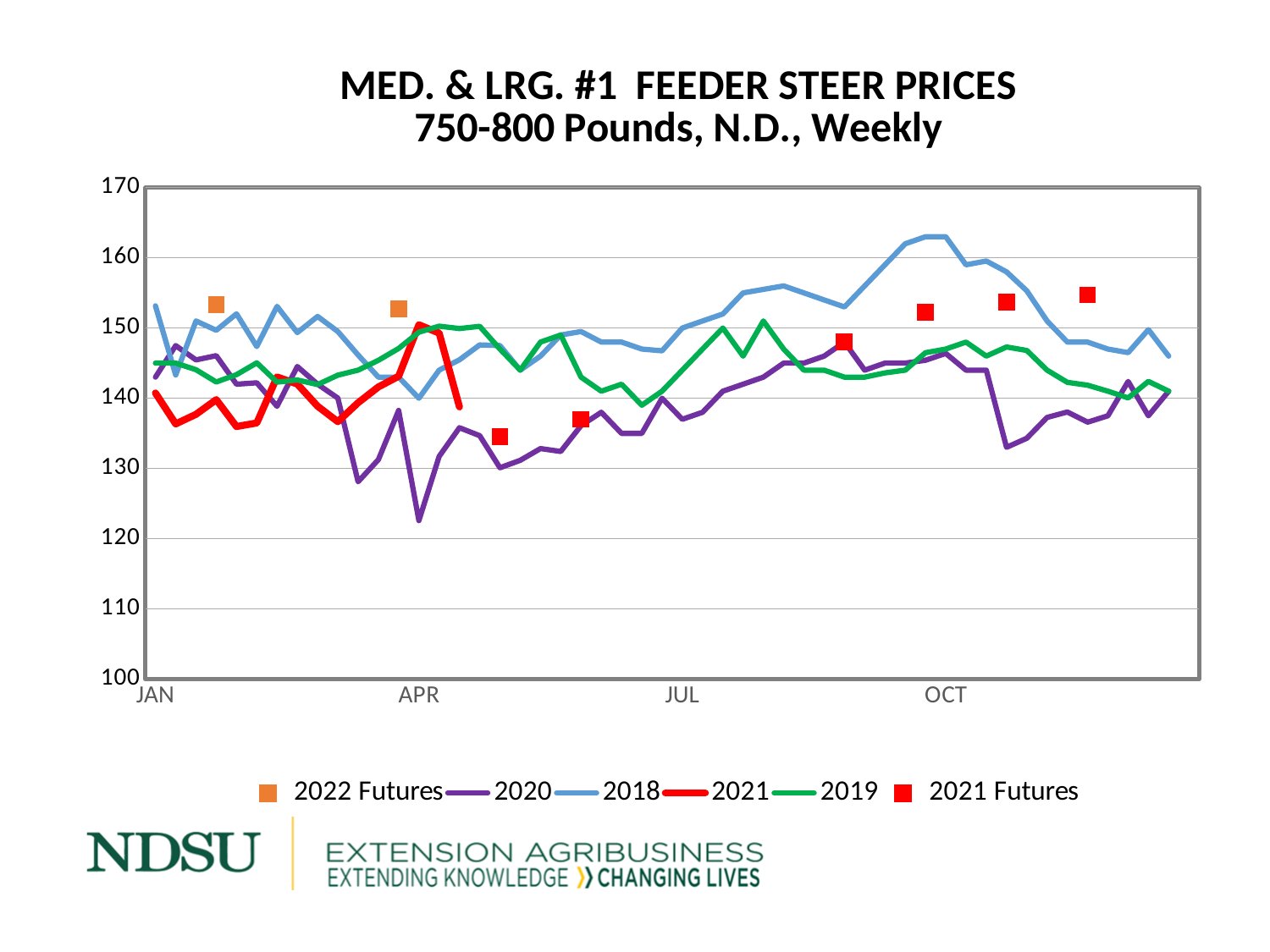
How many series does the legend list? 6 How many 2022 Futures markers are plotted on the chart? 2 Is the peak value of the 2018 line greater or less than 160? greater What is the title of the chart? MED. & LRG. #1 FEEDER STEER PRICES 750-800 Pounds, N.D., Weekly Is the lowest value of the 2020 line, near APR, greater or less than 130? less Is the last 2021 Futures marker, near the right end of the chart, greater or less than 150? greater At OCT, which is higher, the 2018 line or the 2020 line? 2018 Which series reaches the highest value anywhere on the chart? 2018 Which series reaches the lowest value anywhere on the chart? 2020 Between JUL and OCT, does the 2018 line generally rise or fall? rise What kind of chart is shown on the slide? line chart